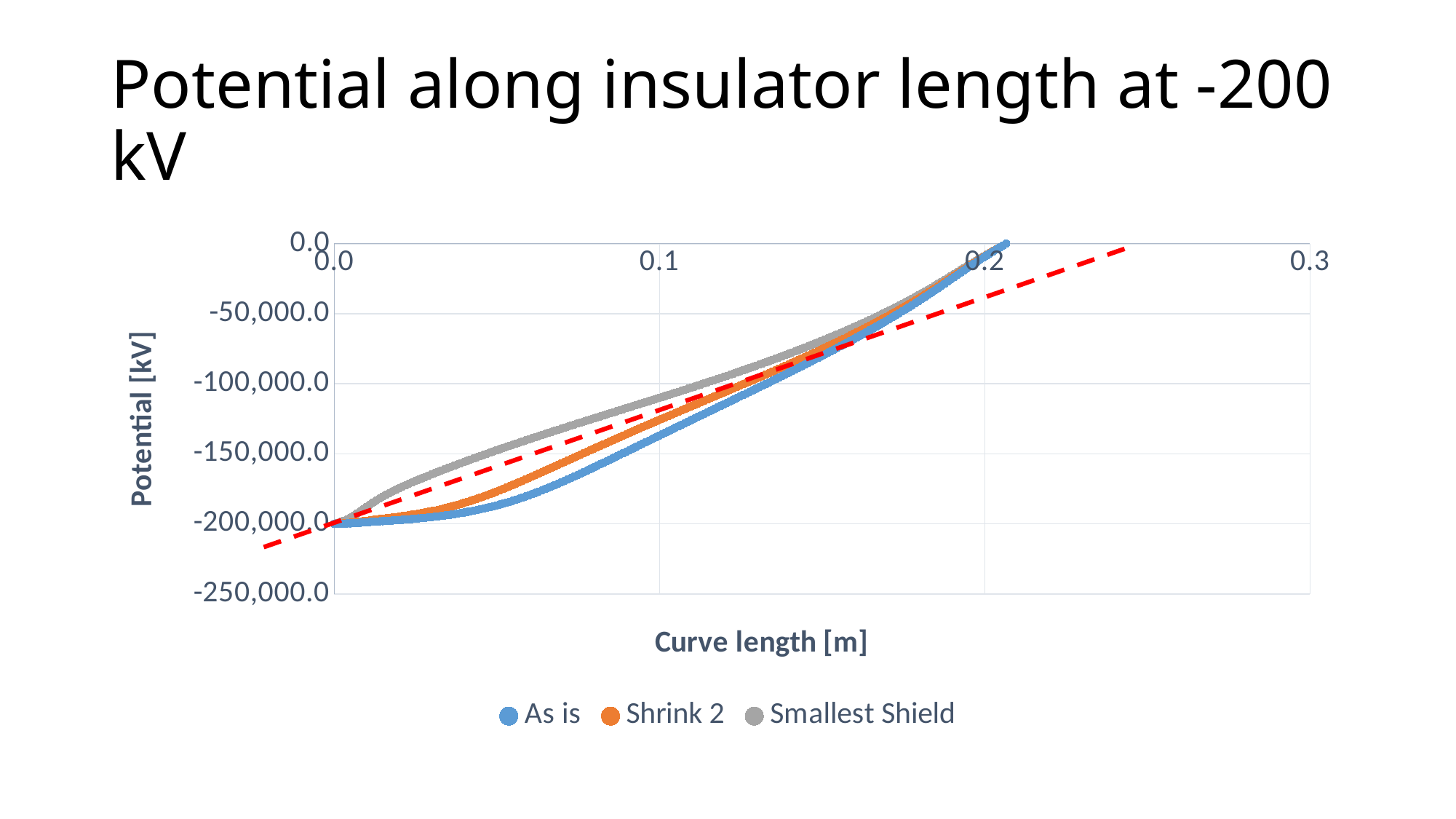
At a curve length of 0.1 m, is the value for 'As is' greater or less than -100,000.0? less What is the title of the chart on the slide? Potential along insulator length at -200 kV At a curve length of 0.05 m, which series has the higher potential, 'As is' or 'Smallest Shield'? Smallest Shield How many series does the legend list? 3 What kind of chart is shown on the slide? line chart How many labelled tick marks are shown on the x axis? 4 At a curve length of 0.05 m, is the value for 'Smallest Shield' greater or less than -200,000.0? greater At a curve length of 0.1 m, is the value for 'Shrink 2' greater or less than -150,000.0? greater At a curve length of 0.05 m, which of the three legend series has the lowest potential? As is What is the label of the x axis? Curve length [m] At a curve length of 0.1 m, which series has the higher potential, 'As is' or 'Shrink 2'? Shrink 2 Do the plotted values for the 'As is' series rise or fall as curve length increases along the x axis? rise